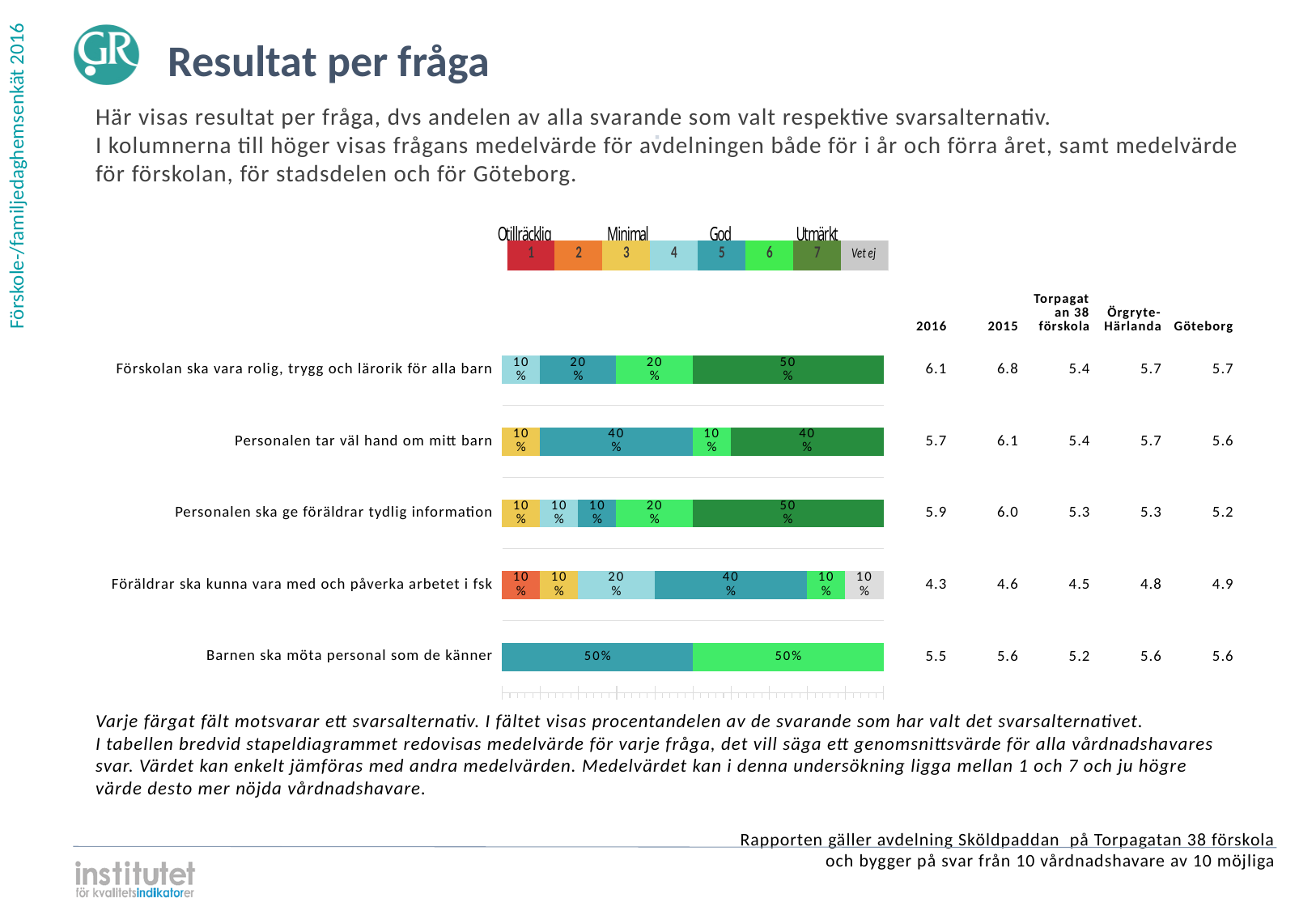
What percentage of respondents answered 'Vet ej' (grey) for 'Föräldrar ska kunna vara med och påverka arbetet i fsk'? 10% What is the difference between the option 7 share and the option 6 share for 'Personalen ska ge föräldrar tydlig information'? 30% What is the 2015 mean value for 'Förskolan ska vara rolig, trygg och lärorik för alla barn'? 6.8 For 'Personalen tar väl hand om mitt barn', is the 2016 mean value larger or smaller than the 2015 mean value? Smaller How many questions (categories) are plotted in the bar chart? 5 What percentage of respondents chose the dark green option 7 for 'Förskolan ska vara rolig, trygg och lärorik för alla barn'? 50% What kind of chart is shown on the slide? Stacked bar chart Which question has the lowest 2016 mean value in the table next to the chart? Föräldrar ska kunna vara med och påverka arbetet i fsk Which question is the only one with a segment in the orange 'Otillräcklig' range (option 2)? Föräldrar ska kunna vara med och påverka arbetet i fsk What percentage of respondents chose the teal option 5 for 'Personalen tar väl hand om mitt barn'? 40% What percentage of respondents chose the light green option 6 for 'Barnen ska möta personal som de känner'? 50% How many response options does the legend above the chart list, including 'Vet ej'? 8